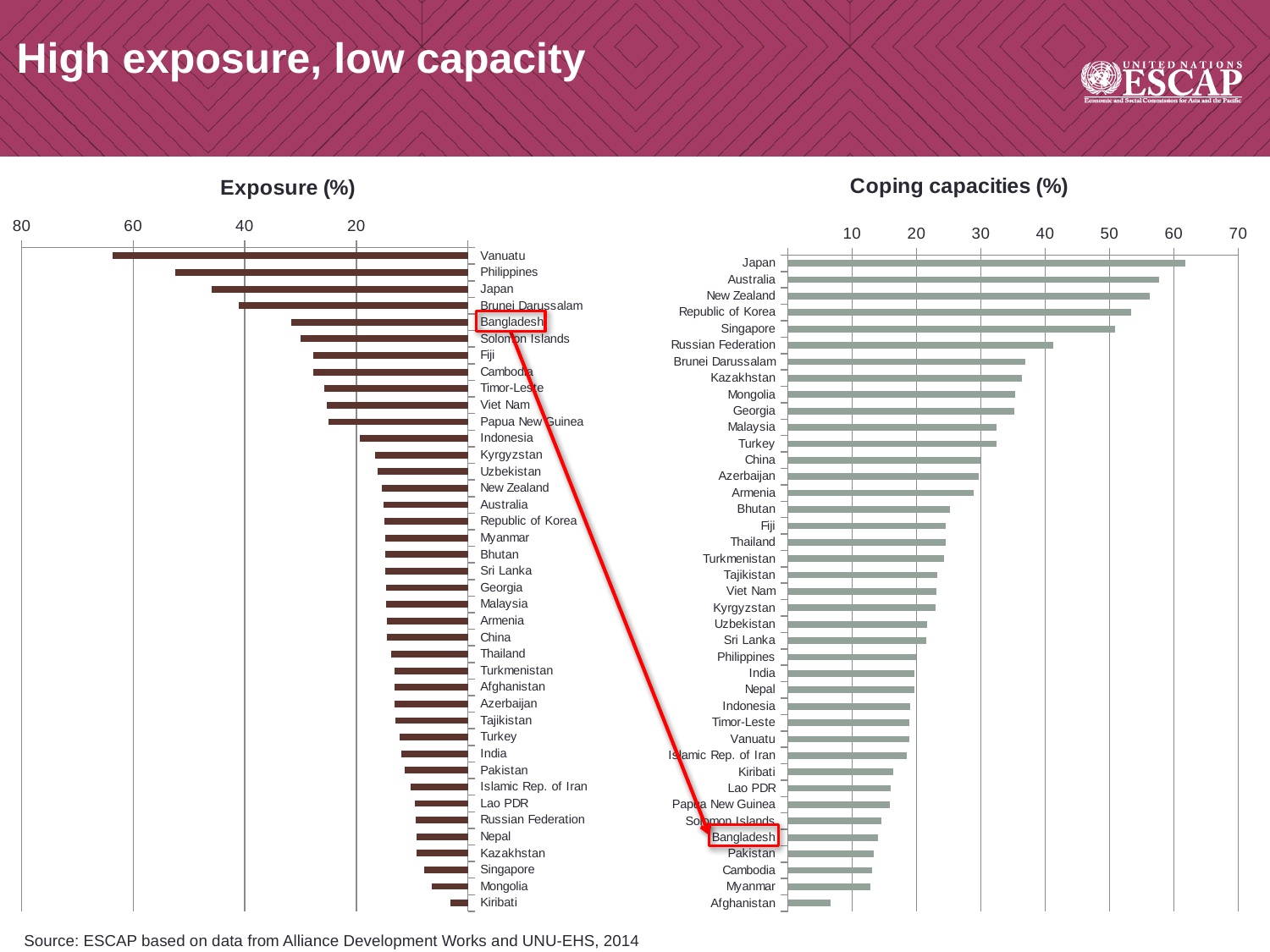
What kind of chart is the Exposure (%) chart? bar chart How many countries are shown in the Coping capacities (%) chart? 40 In the Exposure (%) chart, is the value for Vanuatu greater or less than 60? greater In the Exposure (%) chart, is the value for Bangladesh greater or less than 40? less Which country is highlighted with a red box in both charts? Bangladesh In the Coping capacities (%) chart, which country has the highest coping capacity? Japan In the Coping capacities (%) chart, which country has the lowest coping capacity? Afghanistan In the Exposure (%) chart, which has the larger value, Philippines or Kiribati? Philippines In the Exposure (%) chart, which country has the lowest exposure? Kiribati In the Coping capacities (%) chart, is the value for Afghanistan greater or less than 10? less In the Exposure (%) chart, which country has the highest exposure? Vanuatu